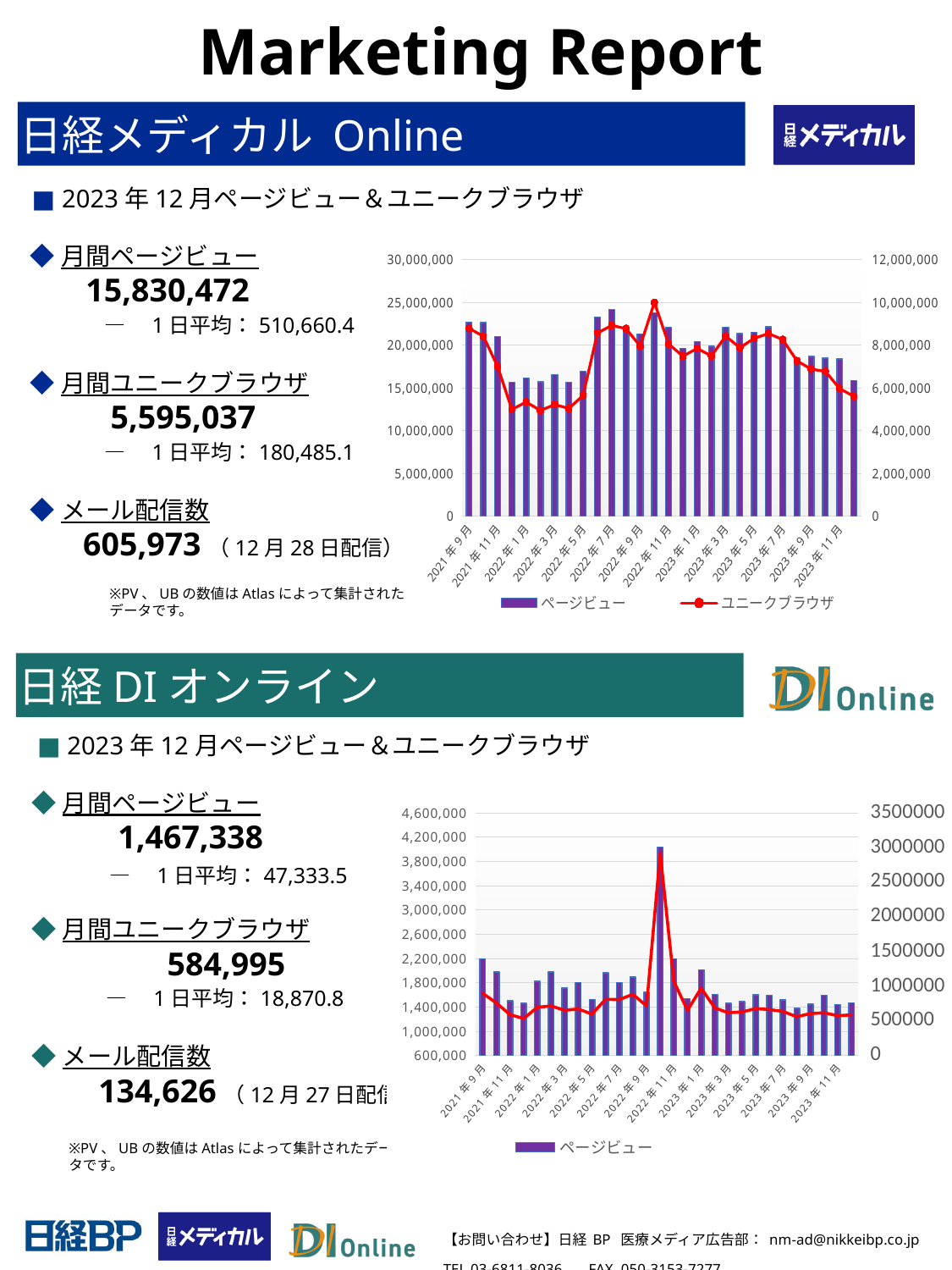
In the top chart (日経メディカル Online), which series is drawn as a red line? ユニークブラウザ How many series does the legend of the top chart (日経メディカル Online) list? 2 In the top chart (日経メディカル Online), is the ページビュー value for 2022年1月 greater or less than 20,000,000? less Which series does the legend of the bottom chart (日経DIオンライン) list? ページビュー What kind of chart is the top chart (日経メディカル Online)? bar chart with a line In the bottom chart (日経DIオンライン), is the ページビュー value for 2022年11月 greater or less than 3,800,000? less What kind of chart is the bottom chart (日経DIオンライン)? bar chart with a line In the top chart (日経メディカル Online), which is larger, the ページビュー value for 2022年7月 or for 2022年1月? 2022年7月 In the top chart (日経メディカル Online), is the ページビュー value for 2022年7月 greater or less than 20,000,000? greater In the top chart (日経メディカル Online), do the ページビュー values rise or fall from 2023年7月 to 2023年11月? fall